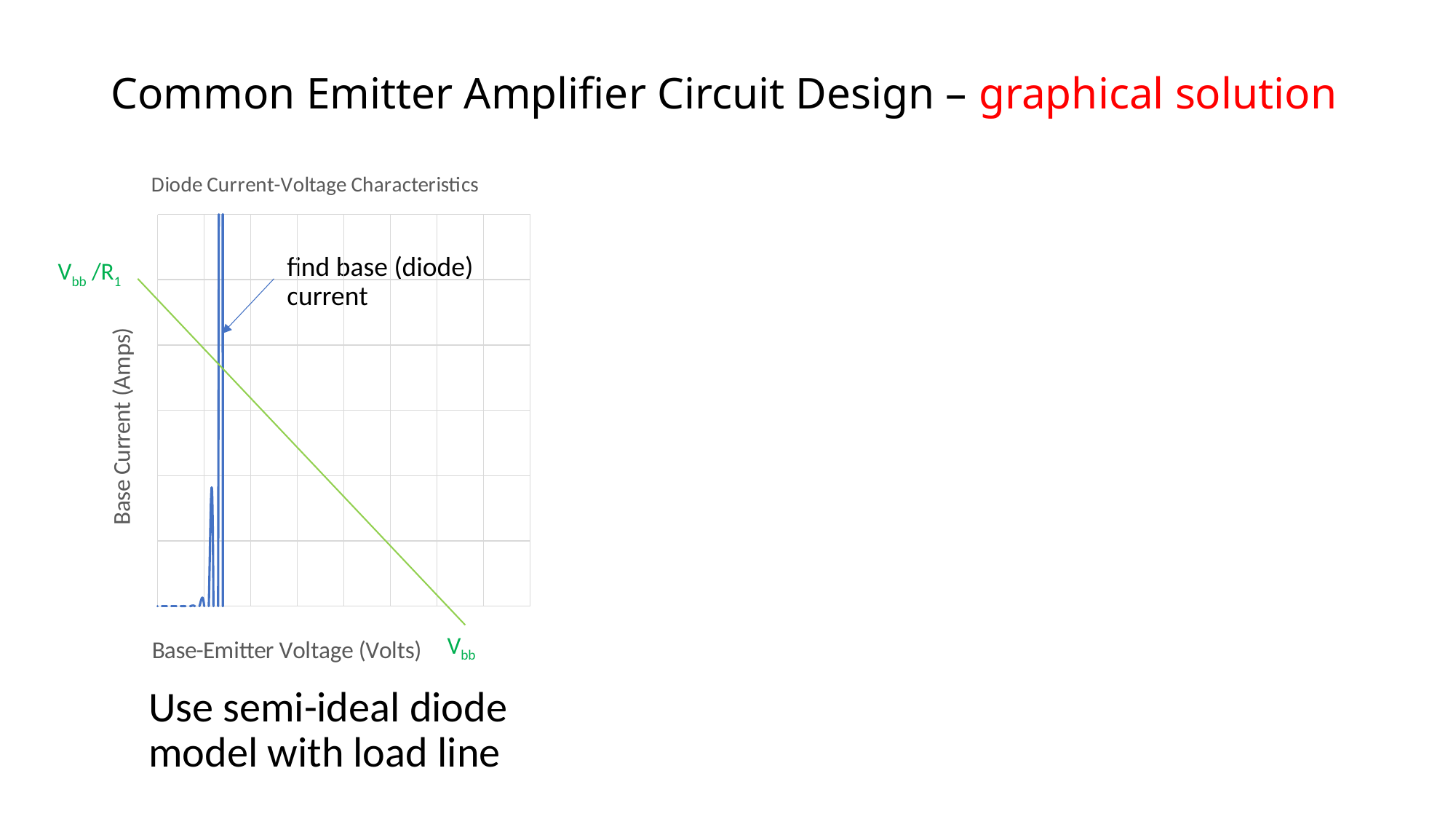
Does the blue diode curve rise or fall as Base-Emitter Voltage increases along the x axis? rises Does the green load line rise or fall as Base-Emitter Voltage increases along the x axis? falls What is the title of the chart? Diode Current-Voltage Characteristics What is the label of the vertical axis of the chart? Base Current (Amps) What kind of chart is shown on the slide? line chart